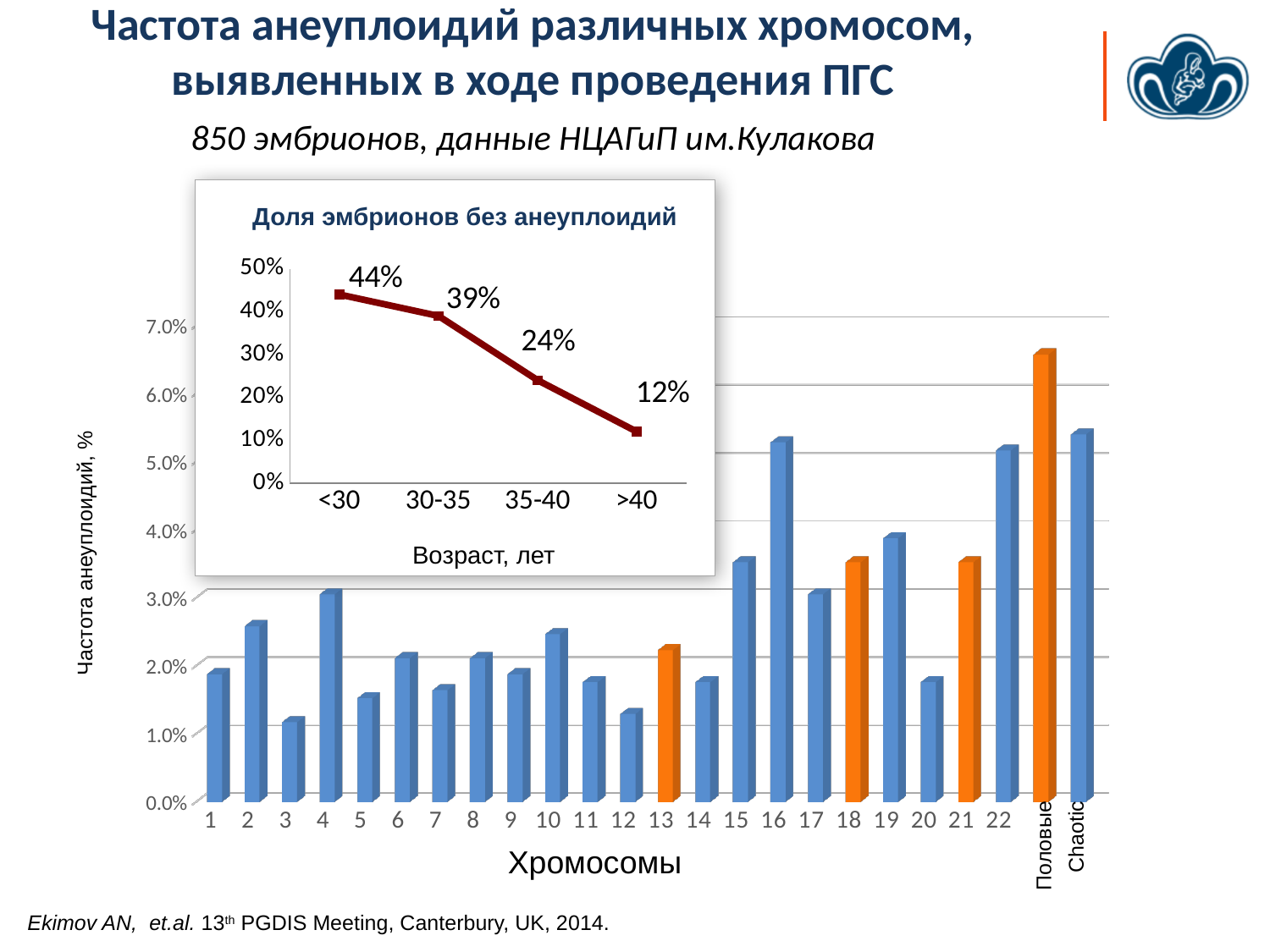
In the inset chart 'Доля эмбрионов без анеуплоидий', which age group has the highest value? <30 What kind of chart is the inset chart 'Доля эмбрионов без анеуплоидий'? line chart In the inset chart 'Доля эмбрионов без анеуплоидий', do the values rise or fall as age increases along the x axis? fall In the large chart of aneuploidy frequency by chromosome, which is larger: the value for chromosome 2 or chromosome 3? chromosome 2 In the large chart of aneuploidy frequency by chromosome, is the value for chromosome 3 greater or less than 2.0%? less In the inset chart 'Доля эмбрионов без анеуплоидий', what is the value for the age group 35-40? 24% In the large chart of aneuploidy frequency by chromosome, which category has the highest bar? Половые How many age groups are plotted in the inset chart 'Доля эмбрионов без анеуплоидий'? 4 In the inset chart 'Доля эмбрионов без анеуплоидий', what is the difference between the values for <30 and >40? 32 percentage points In the large chart of aneuploidy frequency by chromosome, is the value for chromosome 16 greater or less than 5.0%? greater In the inset chart 'Доля эмбрионов без анеуплоидий', what is the value for the age group >40? 12% In the inset chart 'Доля эмбрионов без анеуплоидий', what is the value for the age group <30? 44%